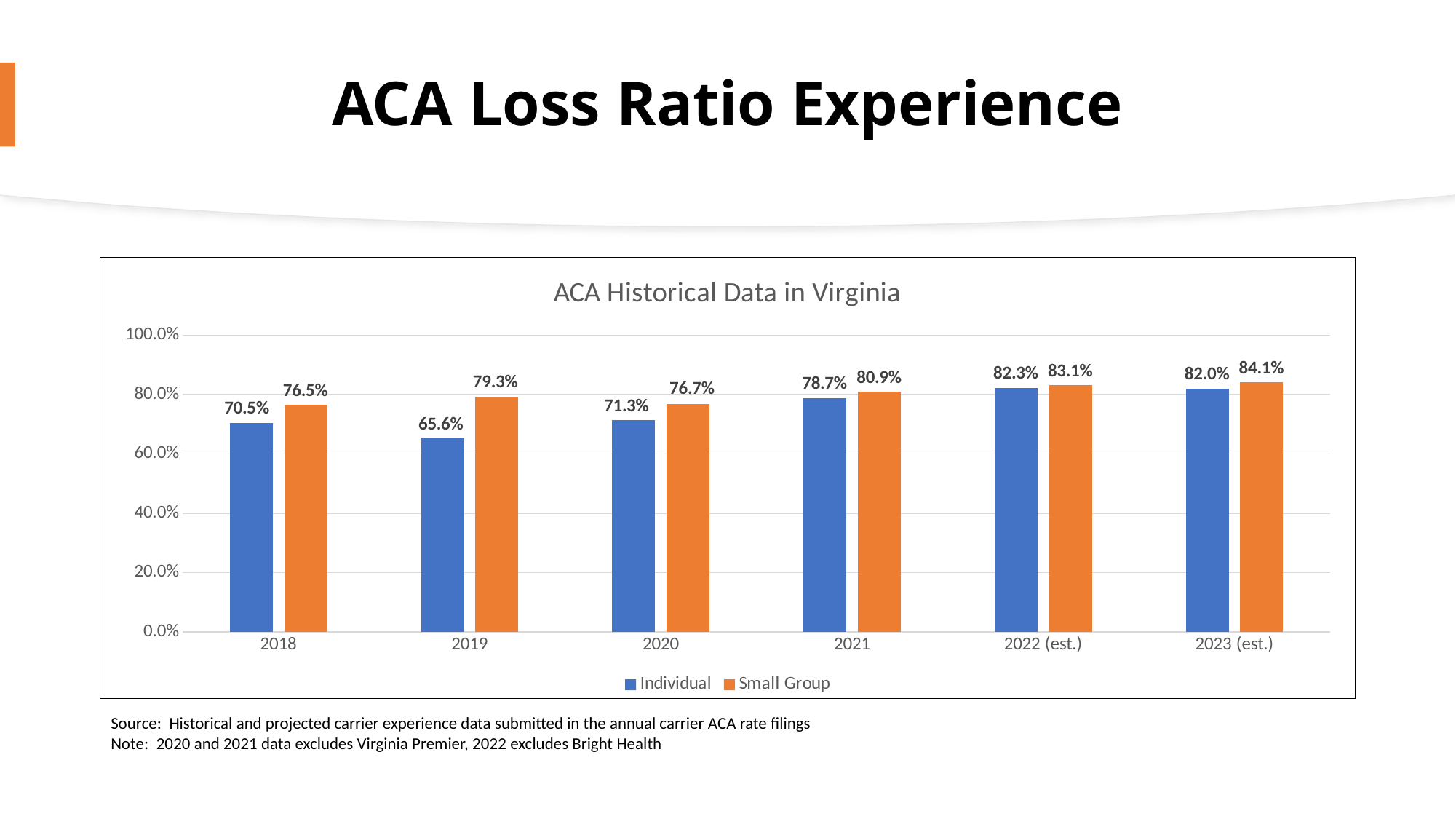
Which is larger in 2021, the Individual or the Small Group loss ratio? Small Group What is the Small Group loss ratio for 2019? 79.3% Which year has the lowest Individual loss ratio? 2019 How many series does the legend list? 2 Is the Individual loss ratio for 2020 greater or less than 80.0%? less What is the Individual loss ratio for 2018? 70.5% Which year has the highest Small Group loss ratio? 2023 (est.) What is the difference between the Small Group and Individual loss ratios in 2019? 13.7% What kind of chart is shown? Bar chart What is the Individual loss ratio for 2023 (est.)? 82.0% How many years are shown on the x axis? 6 What is the title of the chart? ACA Historical Data in Virginia